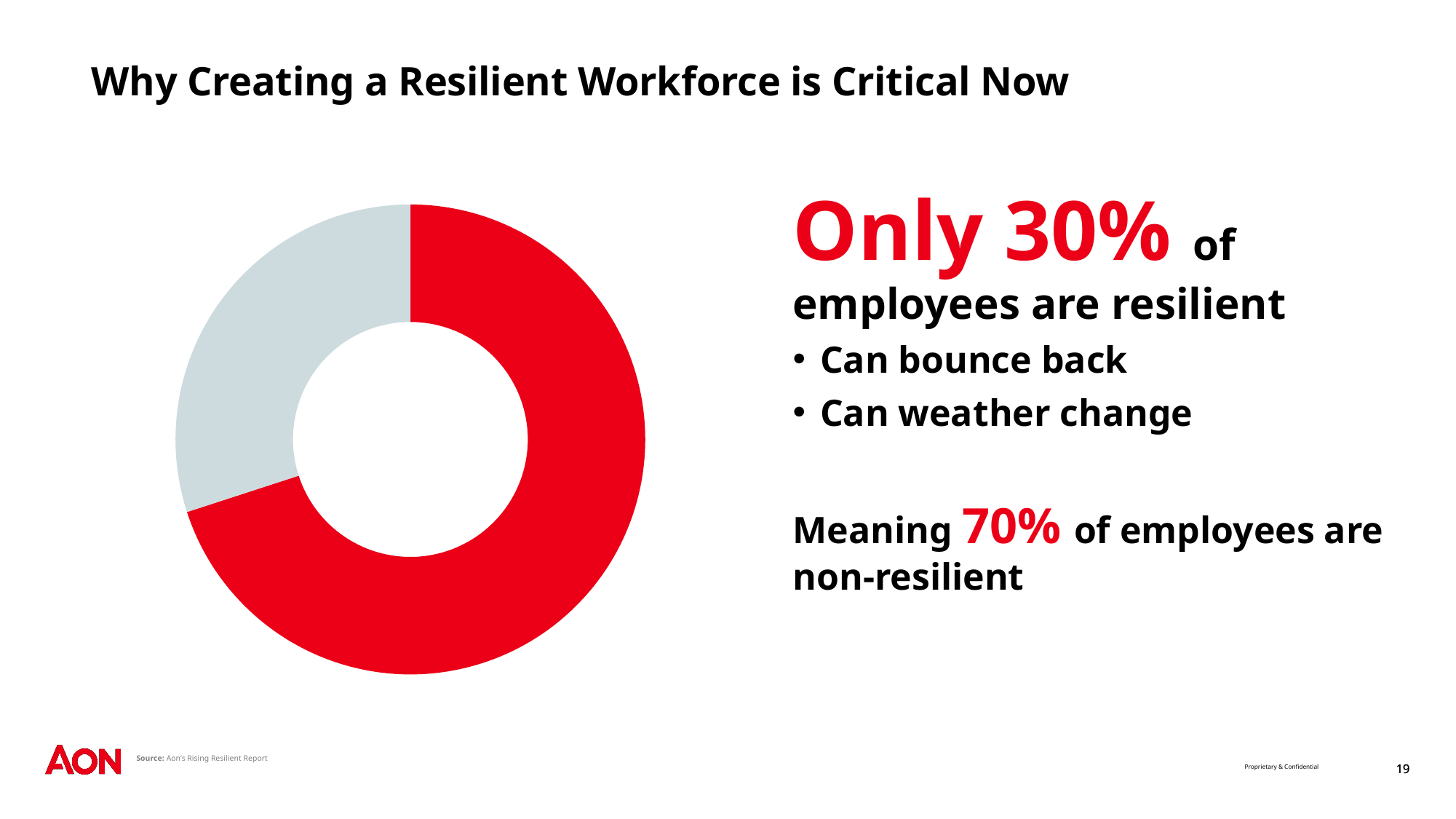
According to the slide, what share of employees are resilient? 30% What is the difference in percentage points between the share of non-resilient employees and the share of resilient employees? 40 percentage points What source is cited for the data on the slide? Aon's Rising Resilient Report Which group makes up the largest share of the donut chart, resilient or non-resilient employees? Non-resilient employees Which slice of the donut chart is larger, the red one or the grey one? The red one What do the two slices of the donut chart add up to? 100% What kind of chart is shown on the slide? Pie chart (donut) Which group makes up the smallest share of the donut chart, resilient or non-resilient employees? Resilient employees According to the slide, what share of employees are non-resilient? 70% How many slices does the donut chart have? 2 Which colour in the donut chart represents the 70% of employees who are non-resilient? Red